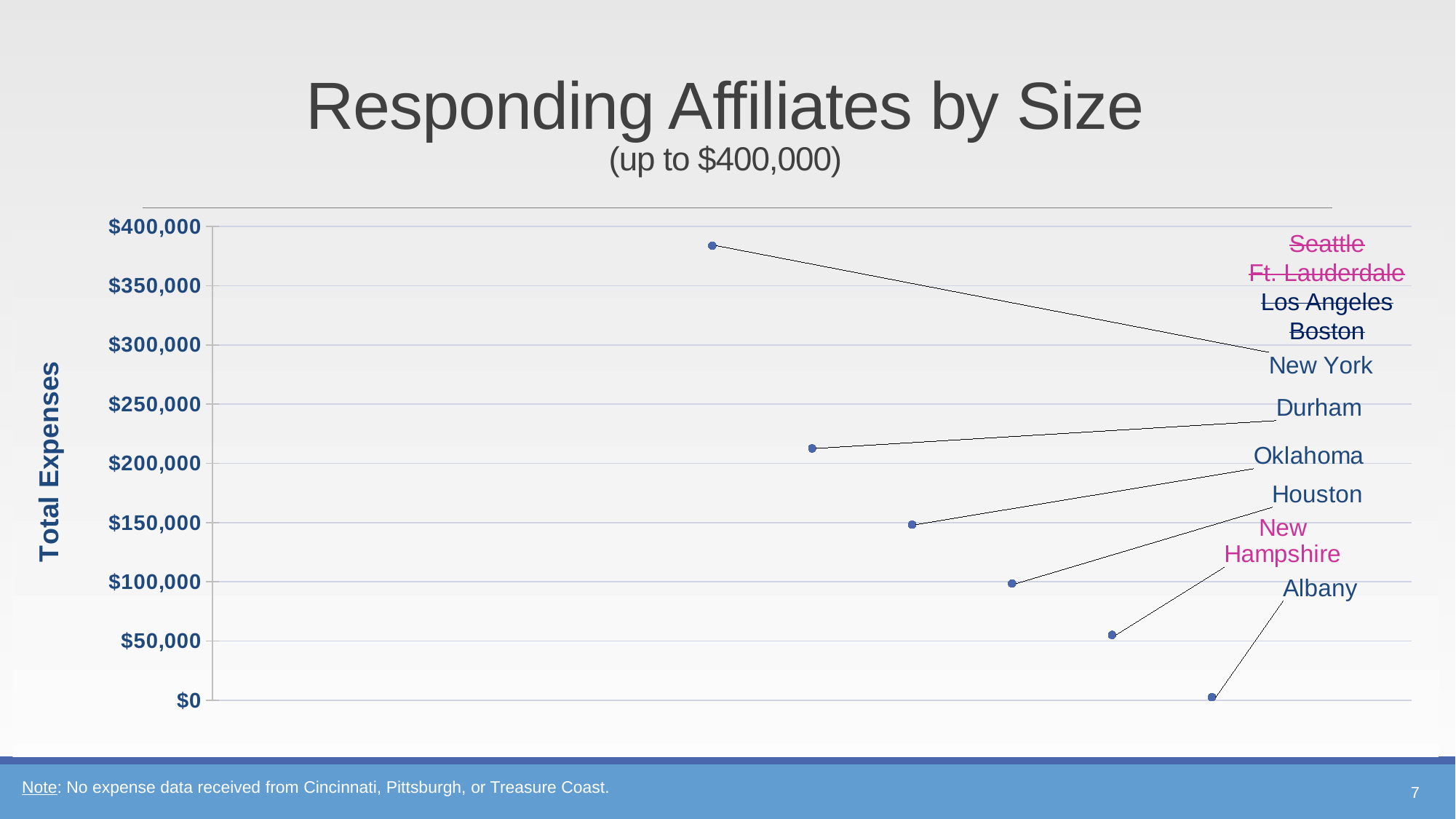
Is the value for Oklahoma greater or less than $100,000? greater What is the label on the vertical axis of the chart? Total Expenses Which affiliate has the highest total expenses on the chart? New York What kind of chart is shown on the slide? scatter chart Which affiliate has the lowest total expenses on the chart? Albany How many data points are plotted on the chart? 6 Which has higher total expenses, Durham or Oklahoma? Durham Is the value for New Hampshire greater or less than $100,000? less Is the value for New York greater or less than $350,000? greater Do the plotted values rise or fall from left to right along the x axis? fall